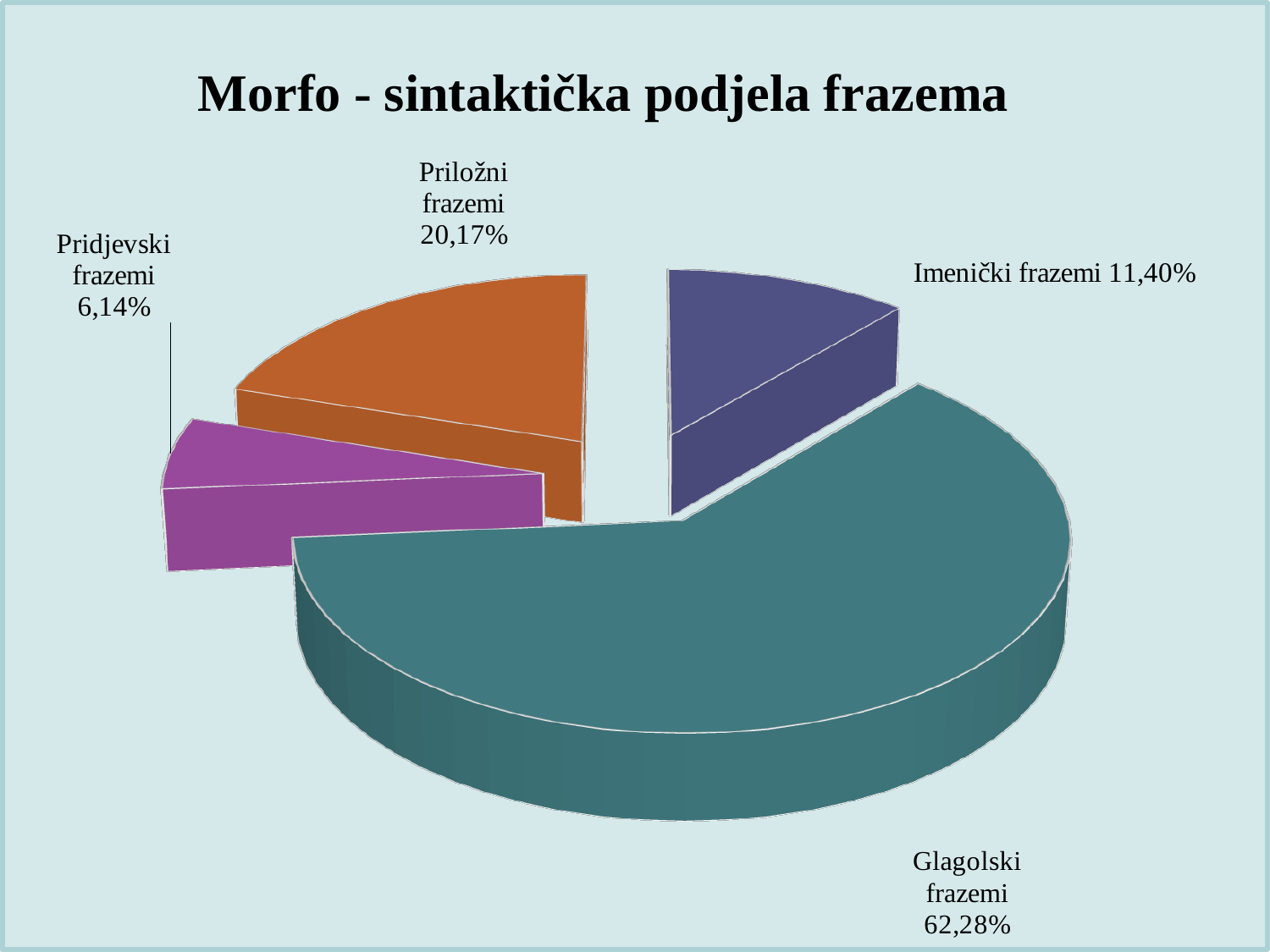
Which category has the largest slice of the pie? Glagolski frazemi How many slices does the pie chart have? 4 What share of the pie is Pridjevski frazemi? 6,14% What kind of chart is shown on the slide? Pie chart Which is larger, Priložni frazemi or Imenički frazemi? Priložni frazemi Which category has the smallest slice of the pie? Pridjevski frazemi What share of the pie is Imenički frazemi? 11,40% What is the title of the chart? Morfo - sintaktička podjela frazema What share of the pie is Priložni frazemi? 20,17% What is the difference in percentage points between Glagolski frazemi and Priložni frazemi? 42,11 What is the difference in percentage points between Imenički frazemi and Pridjevski frazemi? 5,26 What share of the pie is Glagolski frazemi? 62,28%